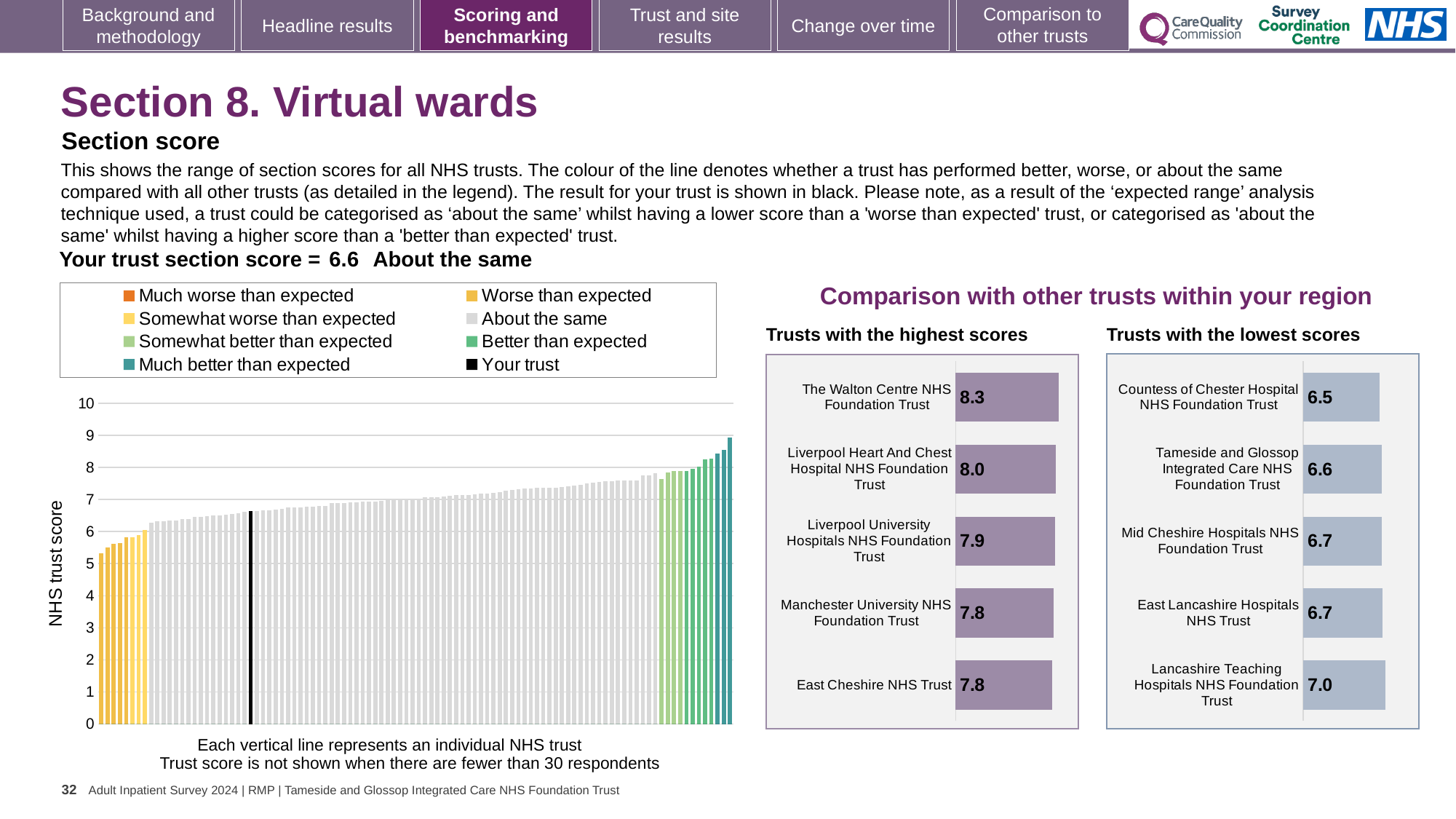
In the 'Trusts with the highest scores' chart, which trust has the highest score? The Walton Centre NHS Foundation Trust In the 'Trusts with the lowest scores' chart, what is the score for Lancashire Teaching Hospitals NHS Foundation Trust? 7.0 How many trusts are shown in the 'Trusts with the highest scores' chart? 5 How many entries does the legend of the large chart on the left list? 8 In the 'Trusts with the lowest scores' chart, which trust has the lowest score? Countess of Chester Hospital NHS Foundation Trust In the 'Trusts with the highest scores' chart, what is the score for The Walton Centre NHS Foundation Trust? 8.3 In the 'Trusts with the lowest scores' chart, which has the larger score: Mid Cheshire Hospitals NHS Foundation Trust or Countess of Chester Hospital NHS Foundation Trust? Mid Cheshire Hospitals NHS Foundation Trust In the 'Trusts with the lowest scores' chart, what is the difference between the scores of Lancashire Teaching Hospitals NHS Foundation Trust and Countess of Chester Hospital NHS Foundation Trust? 0.5 In the 'Trusts with the highest scores' chart, what is the difference between the scores of The Walton Centre NHS Foundation Trust and East Cheshire NHS Trust? 0.5 What kind of chart is the large chart on the left showing NHS trust scores? Bar chart In the large chart on the left, is the value of the black bar representing your trust greater or less than 7? less In the large chart on the left, do the trust scores rise or fall from left to right? Rise